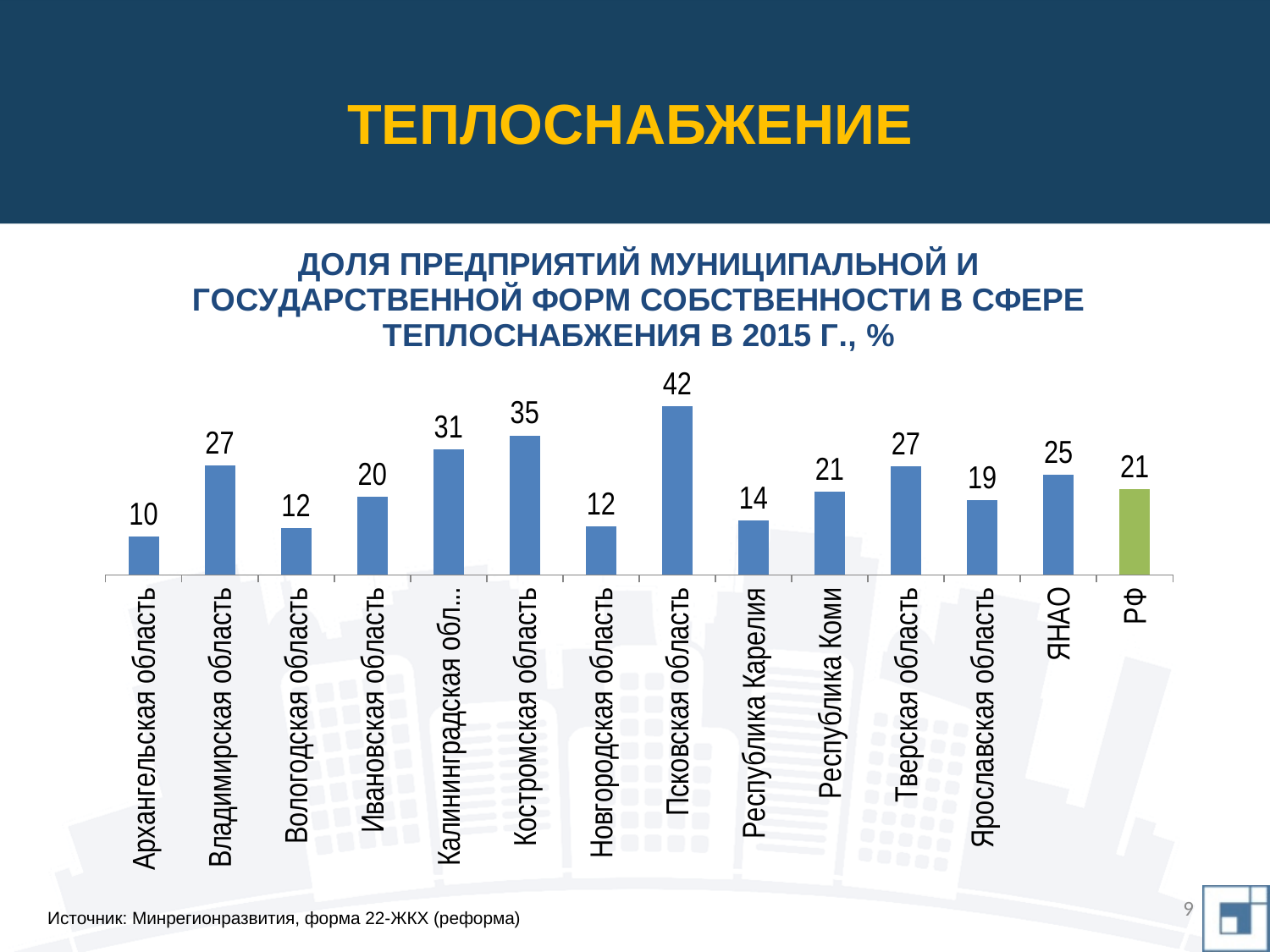
Which bar is coloured green instead of blue? РФ How many bars are shown in the chart? 14 Which region has the highest value? Псковская область What is the value for Псковская область? 42 Which region has the lowest value? Архангельская область Which is larger, the value for Костромская область or for Ивановская область? Костромская область What is the value for ЯНАО? 25 What kind of chart is shown on the slide? bar chart What is the value for Республика Карелия? 14 What is the value for РФ? 21 What is the difference between the values for Владимирская область and Ивановская область? 7 What is the difference between the values for Псковская область and Архангельская область? 32